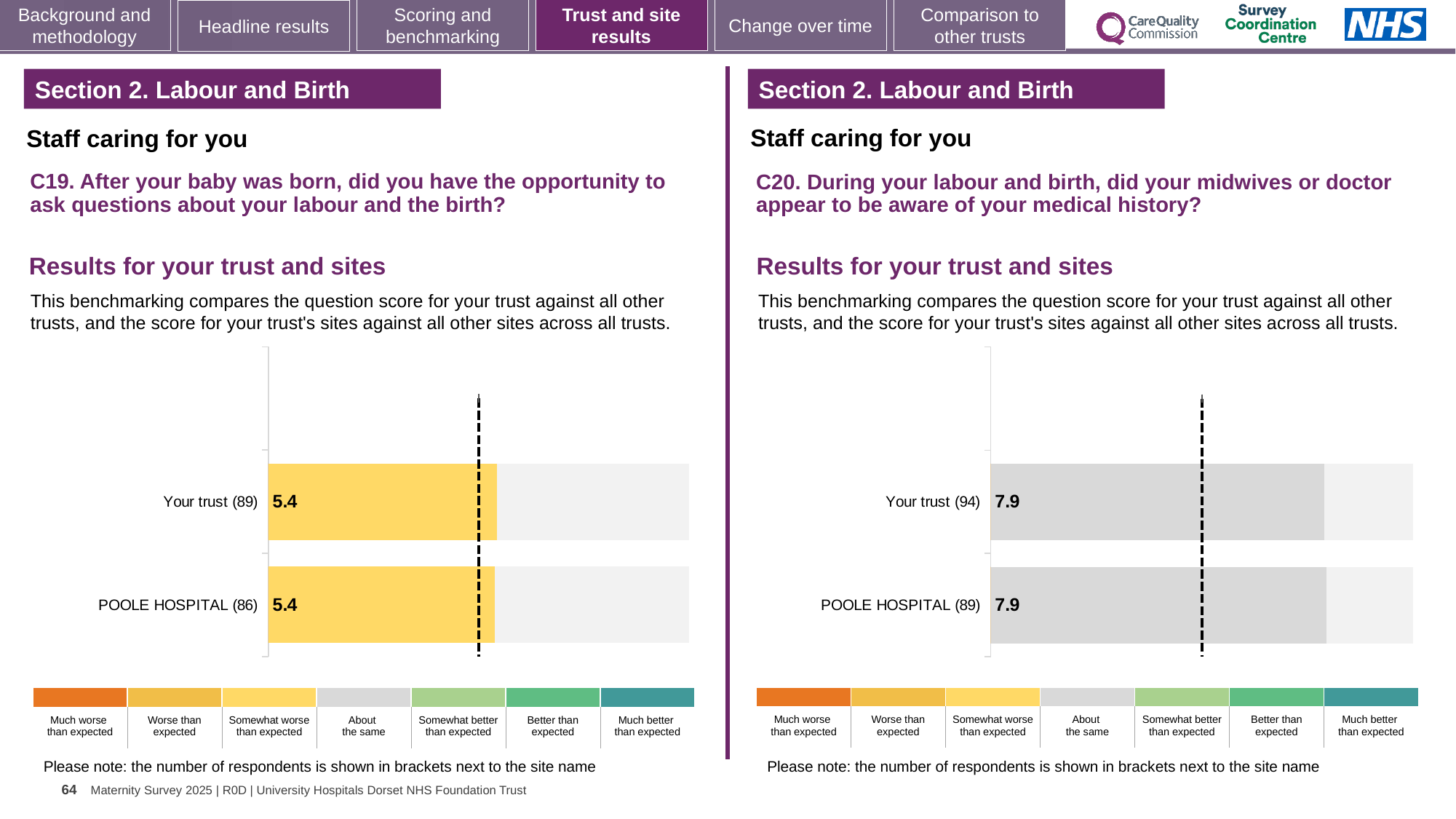
On the left chart (C19), what is the difference between the Your trust score and the POOLE HOSPITAL score? 0 On the left chart (C19), what is the score for Your trust? 5.4 How many bars are plotted on the right chart (C20)? 2 How many bars are plotted on the left chart (C19)? 2 On the left chart (C19), what is the score for POOLE HOSPITAL? 5.4 According to the legend, which benchmark category does the yellow colour of the bars on the left chart (C19) represent? Somewhat worse than expected On the right chart (C20), what is the score for POOLE HOSPITAL? 7.9 On the right chart (C20), what is the score for Your trust? 7.9 On the right chart (C20), how many respondents are shown in brackets for POOLE HOSPITAL? 89 On the right chart (C20), what is the difference between the Your trust score and the POOLE HOSPITAL score? 0 What kind of chart is used on the left (C19)? Bar chart On the left chart (C19), how many respondents are shown in brackets for Your trust? 89